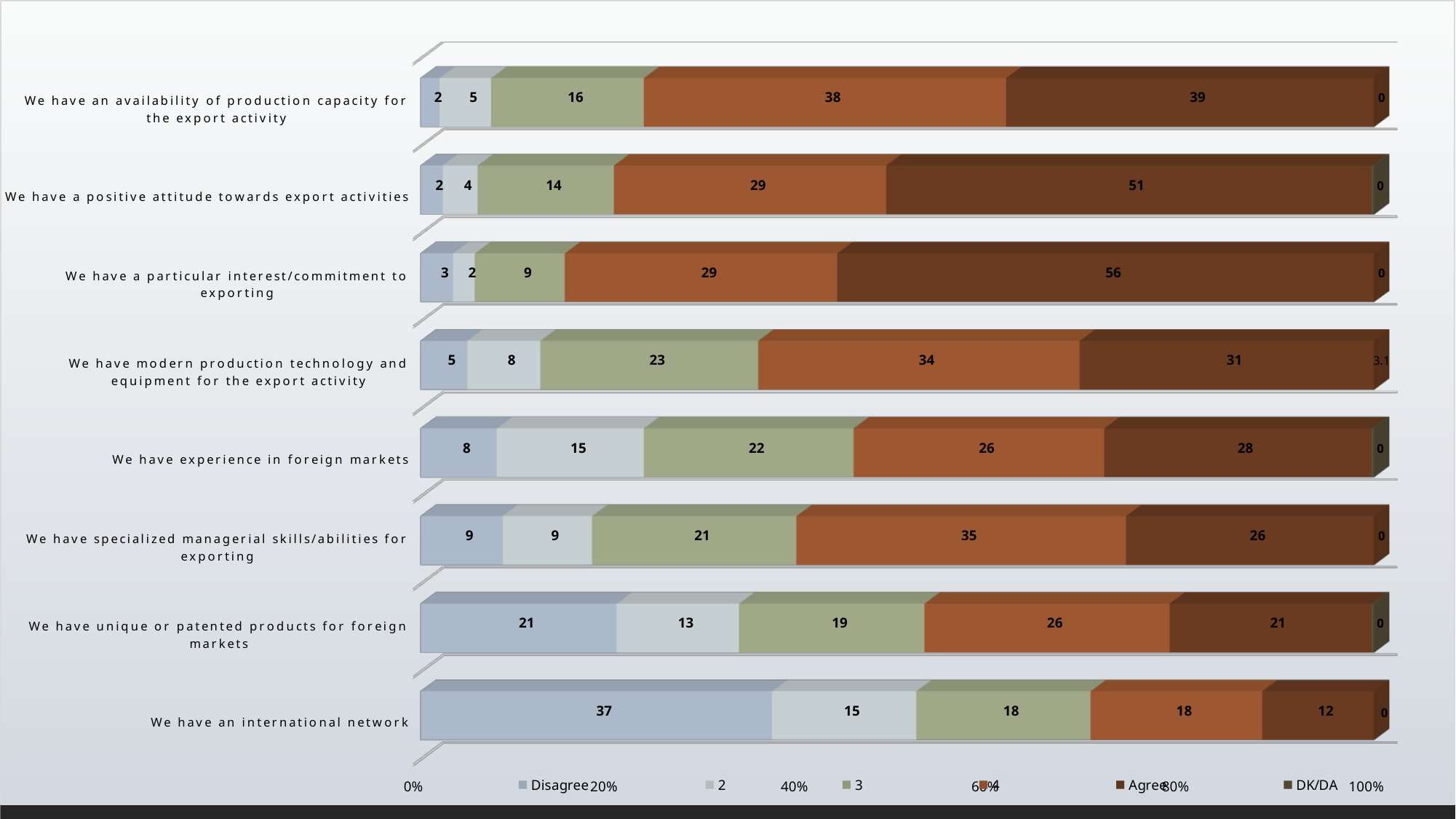
Which category has the lowest Agree value? We have an international network What is the Agree value for "We have a positive attitude towards export activities"? 51 What is the difference between the Agree value and the series 4 value for "We have a positive attitude towards export activities"? 22 What is the value of series 3 for "We have modern production technology and equipment for the export activity"? 23 Which category has the highest Disagree value? We have an international network Which is larger: the Agree value for "We have an availability of production capacity for the export activity" or the Agree value for "We have experience in foreign markets"? We have an availability of production capacity for the export activity How many series does the legend list? 6 What kind of chart is shown on the slide? Stacked bar chart What is the total of the stacked bar for "We have an international network"? 100 How many categories (statements) are shown on the chart? 8 Which category has the highest Agree value? We have a particular interest/commitment to exporting What is the Disagree value for "We have an international network"? 37